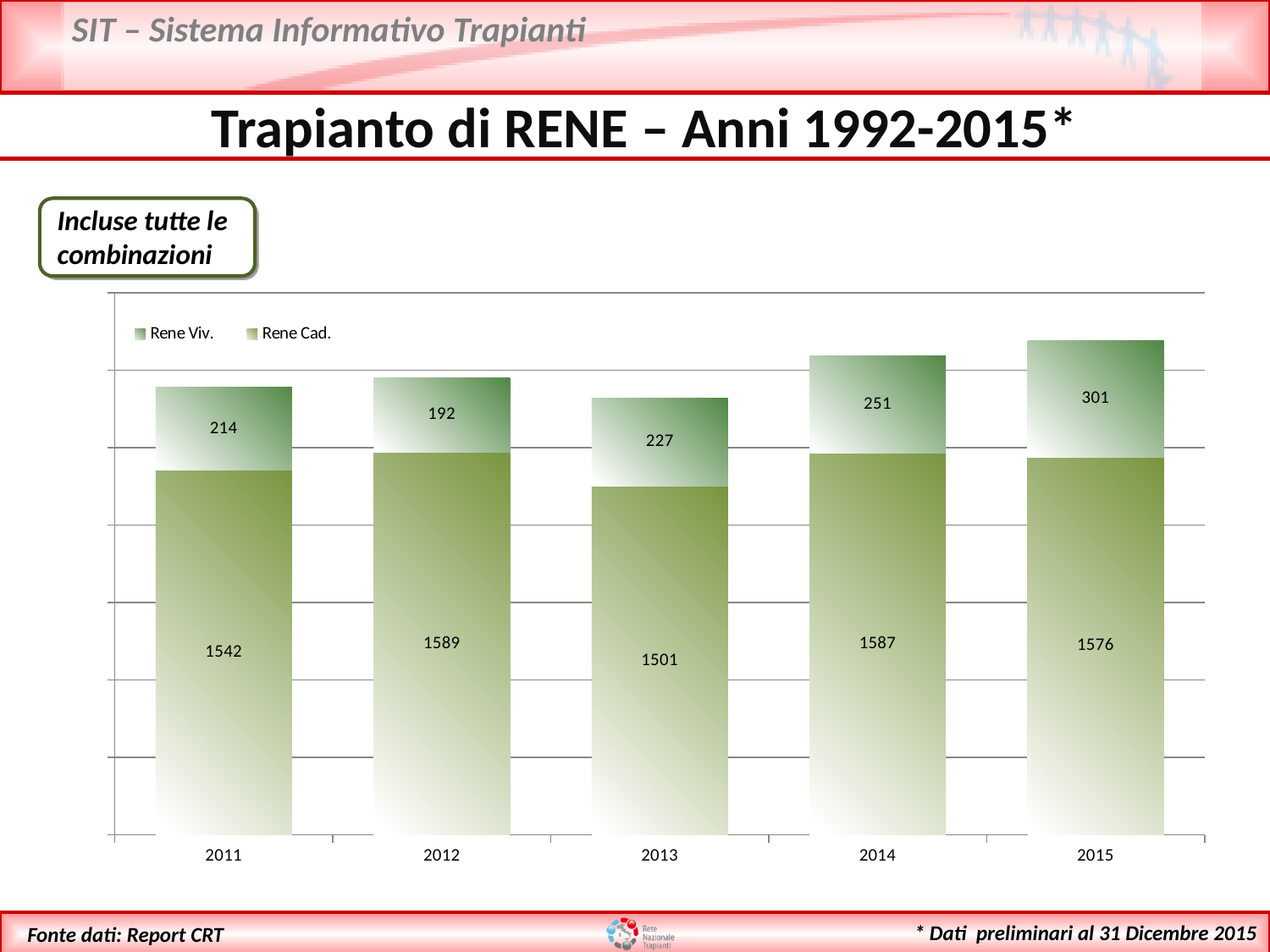
What is the Rene Viv. value for 2015? 301 Which year has the highest Rene Viv. value? 2015 What is the Rene Cad. value for 2013? 1501 How many series does the legend list? 2 How many years are shown on the x axis? 5 What is the difference between the Rene Viv. values for 2015 and 2014? 50 Which is larger, the Rene Cad. value for 2012 or for 2014? 2012 What is the Rene Viv. value for 2012? 192 Which year has the lowest Rene Cad. value? 2013 What is the total of the stacked bar for 2015? 1877 What kind of chart is shown on the slide? Stacked bar chart What is the total of the stacked bar for 2011? 1756